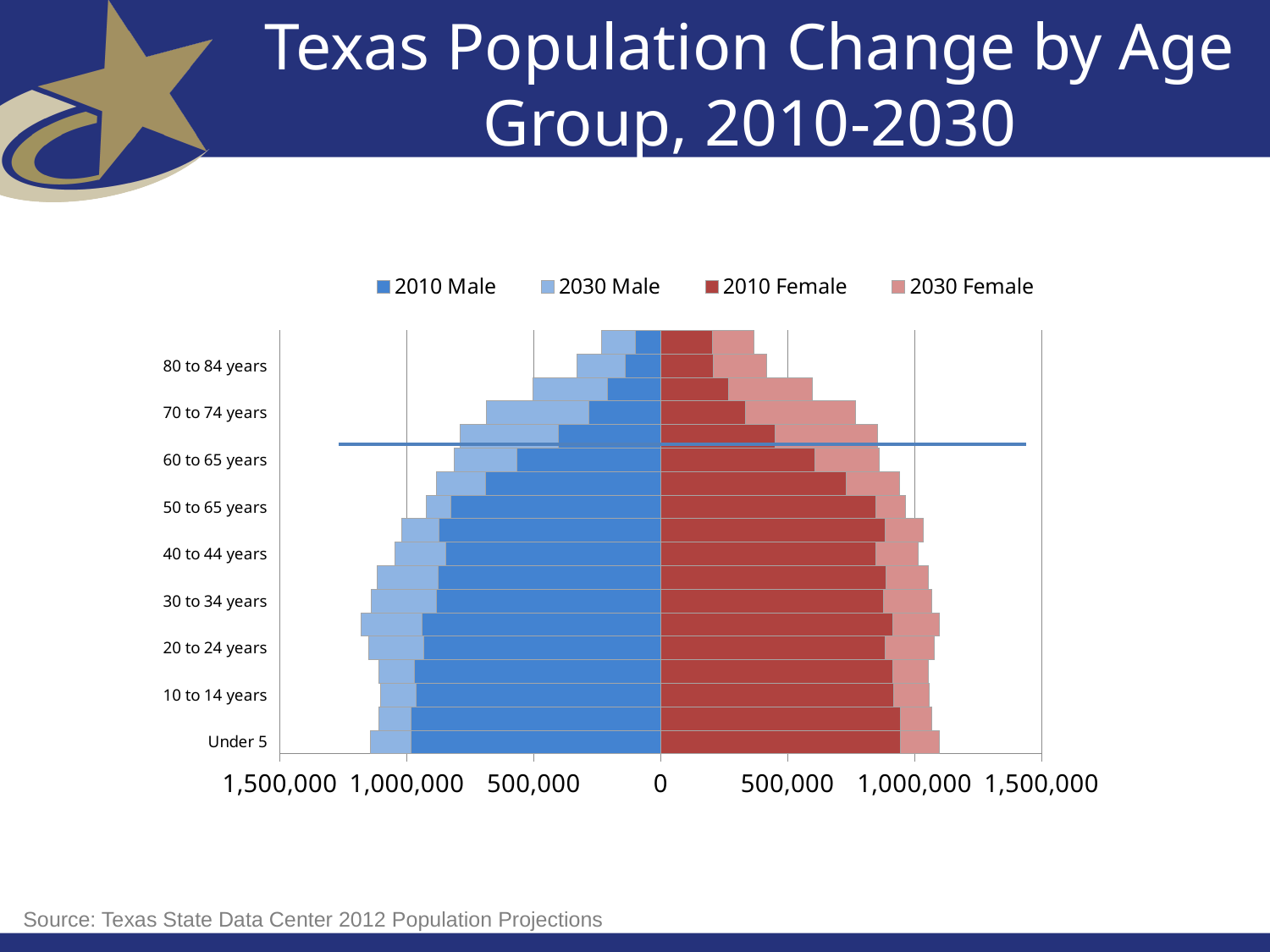
Which series is shown in dark red? 2010 Female How many series does the legend list? 4 What is the title of the chart on the slide? Texas Population Change by Age Group, 2010-2030 Do the 2010 Male values rise or fall as the age groups go from Under 5 up to 80 to 84 years? fall What kind of chart is shown on the slide? bar chart Is the 2010 Male value for 80 to 84 years greater or less than 500,000? less Of the labeled age groups, which has the smallest 2010 Male value? 80 to 84 years Is the 2010 Female value for Under 5 greater or less than 1,000,000? less For 70 to 74 years, which is larger: the 2010 Female value or the 2030 Female value? 2030 Female